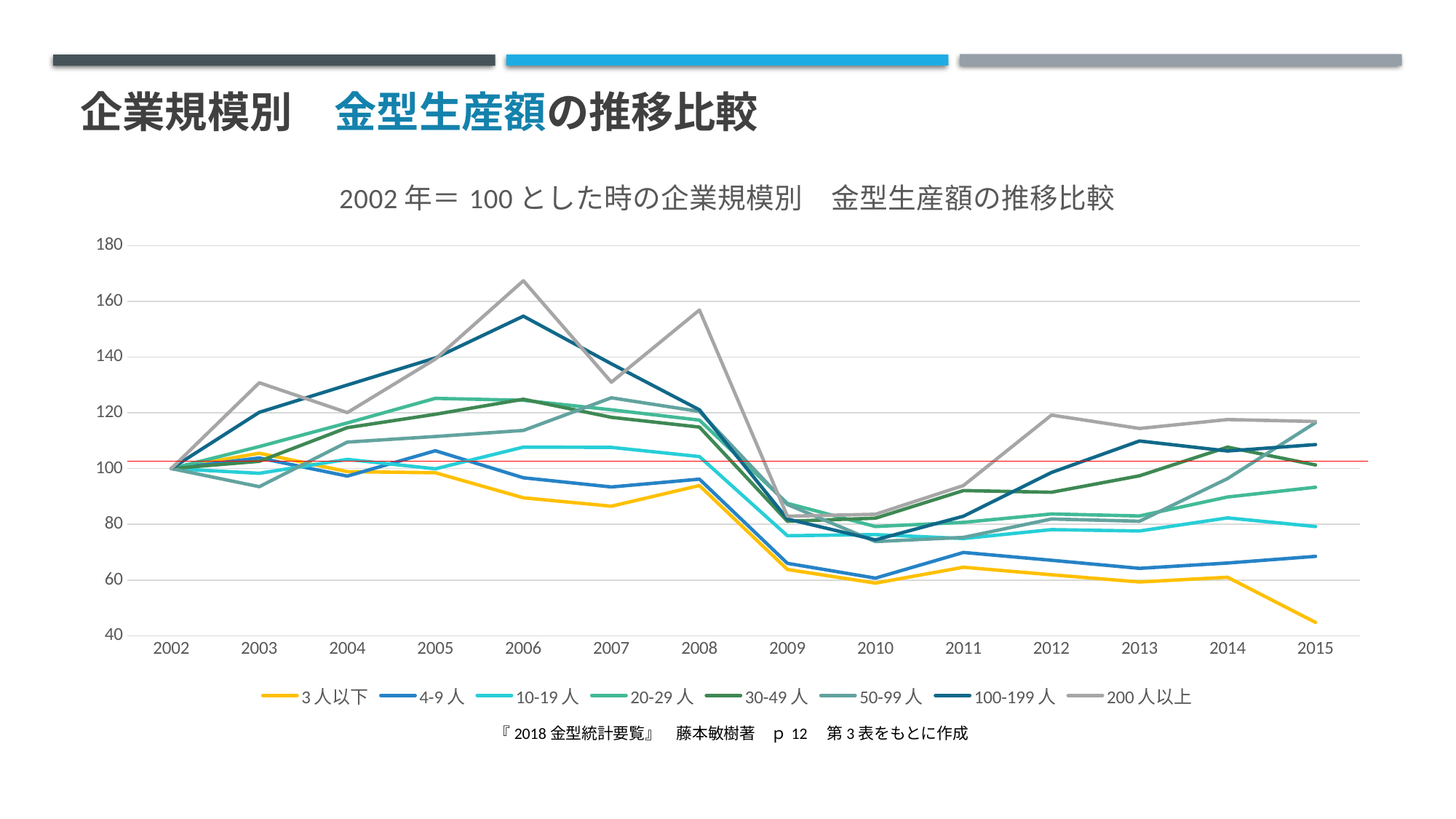
What kind of chart is shown on the slide? line chart How many years are shown along the x axis? 14 Is the value for 3人以下 in 2015 greater or less than 60? less Which series has the lowest value in 2015? 3人以下 What is the title of the chart? 2002年＝100とした時の企業規模別 金型生産額の推移比較 What is the value for every series in 2002? 100 Is the value for 10-19人 in 2009 greater or less than 80? less Does the value for 200人以上 rise or fall from 2008 to 2010? fall Which series has the highest value in 2006? 200人以上 Is the value for 200人以上 in 2006 greater or less than 160? greater How many series does the legend list? 8 In 2015, which is larger: the value for 3人以下 or the value for 4-9人? 4-9人